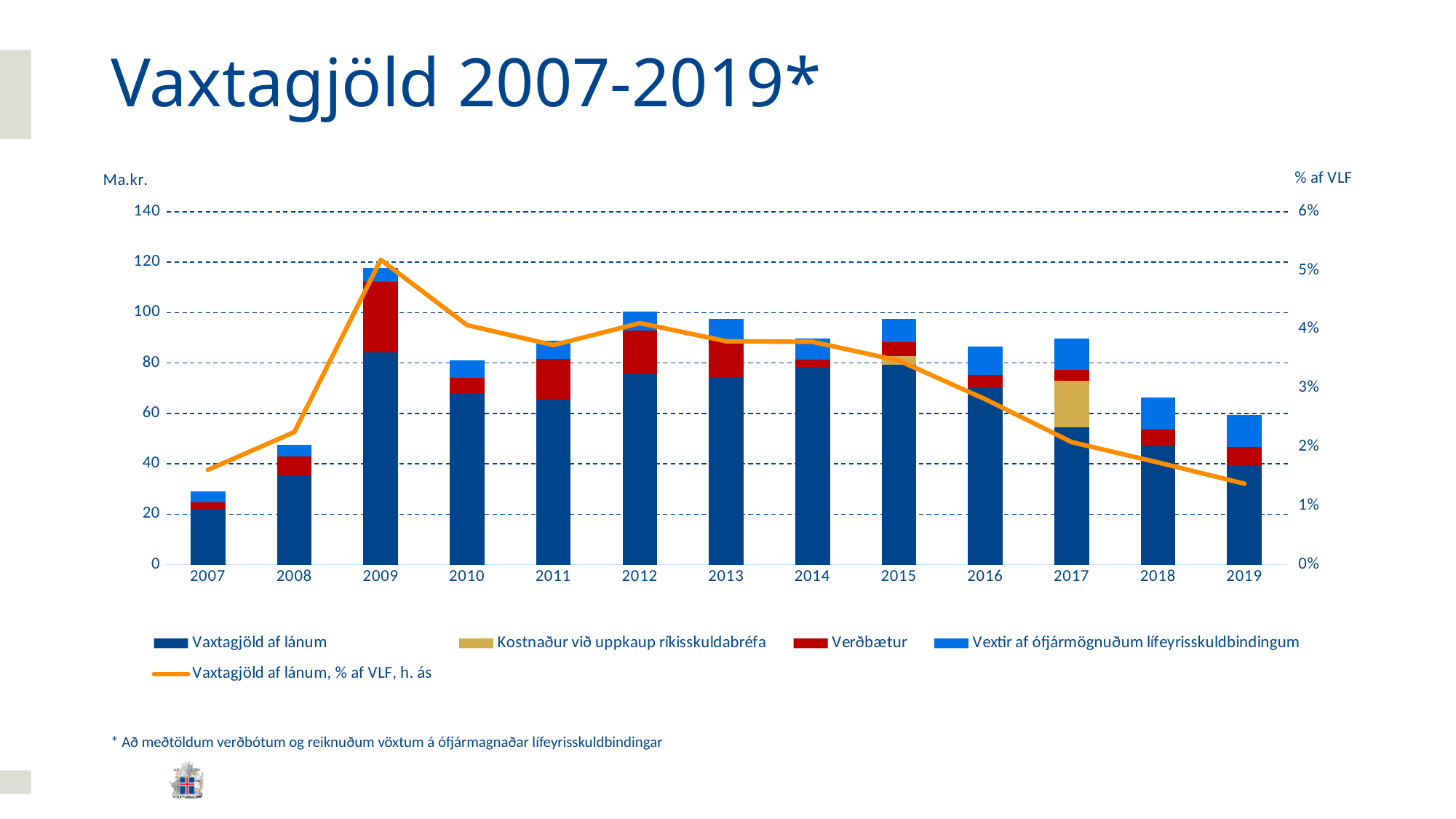
Is the total of the stacked bar for 2009 greater or less than 100? greater What kind of chart is shown on the slide? A stacked bar chart with a line What unit label is shown above the left axis of the chart? Ma.kr. How many years are shown on the x axis of the chart? 13 Does the line 'Vaxtagjöld af lánum, % af VLF, h. ás' rise or fall from 2012 to 2019? fall In which year does the line 'Vaxtagjöld af lánum, % af VLF, h. ás' reach its highest point? 2009 Is the total of the stacked bar for 2018 greater or less than 60? greater How many series does the chart legend list? 5 Which stacked bar is taller, 2012 or 2019? 2012 Which year has the shortest stacked bar? 2007 Is the total of the stacked bar for 2007 greater or less than 40? less Which year has the tallest stacked bar? 2009